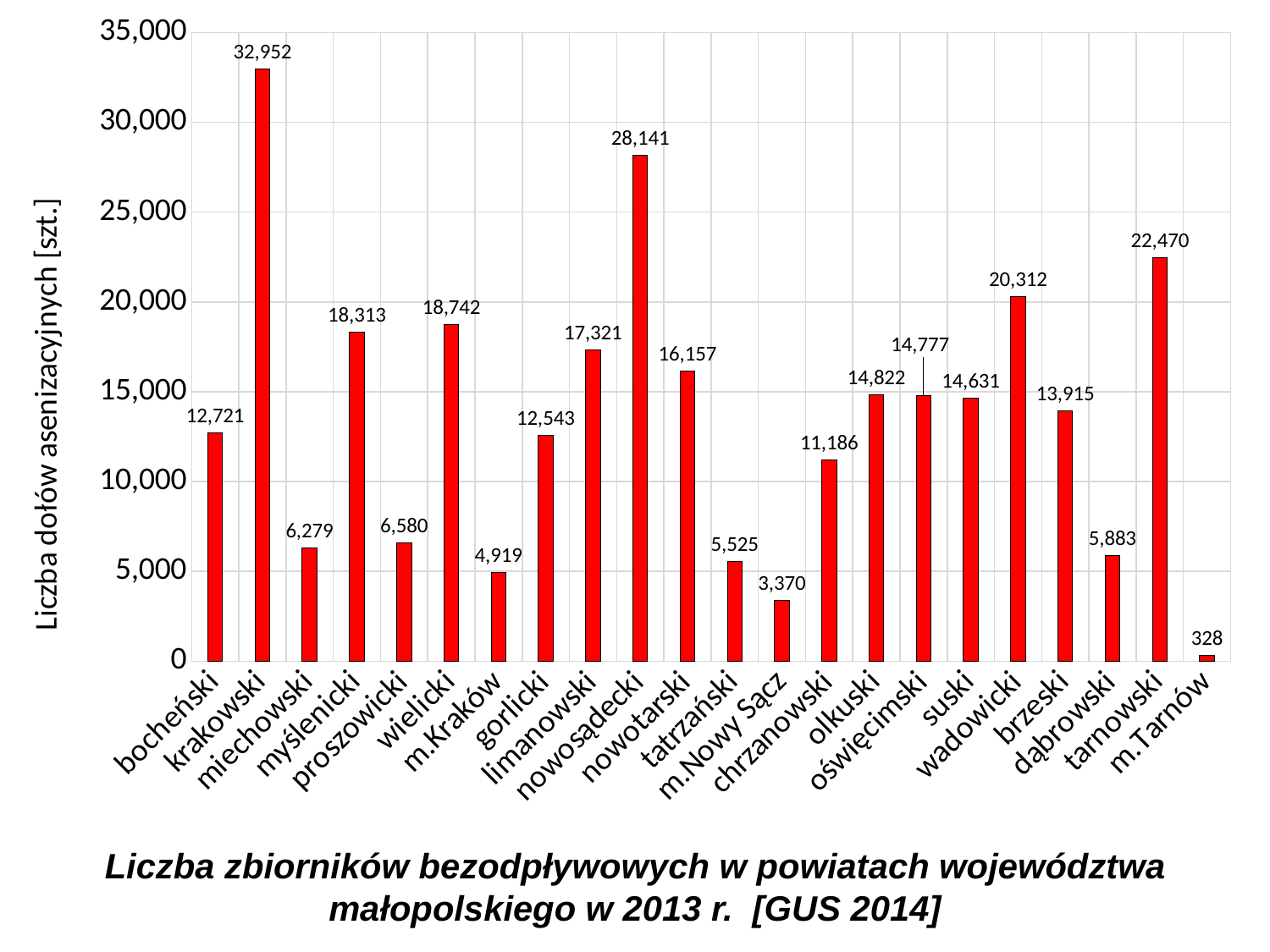
What is the value for nowosądecki? 28,141 Which category has the highest value? krakowski What kind of chart is this? bar chart What is the y-axis label of the chart? Liczba dołów asenizacyjnych [szt.] What is the difference between the values for tarnowski and wadowicki? 2,158 What is the value for krakowski? 32,952 What is the difference between the values for krakowski and nowosądecki? 4,811 What is the value for oświęcimski? 14,777 How many categories are shown on the x axis? 22 Which category has the lowest value? m.Tarnów Which is larger, the value for limanowski or the value for nowotarski? limanowski What is the value for m.Kraków? 4,919